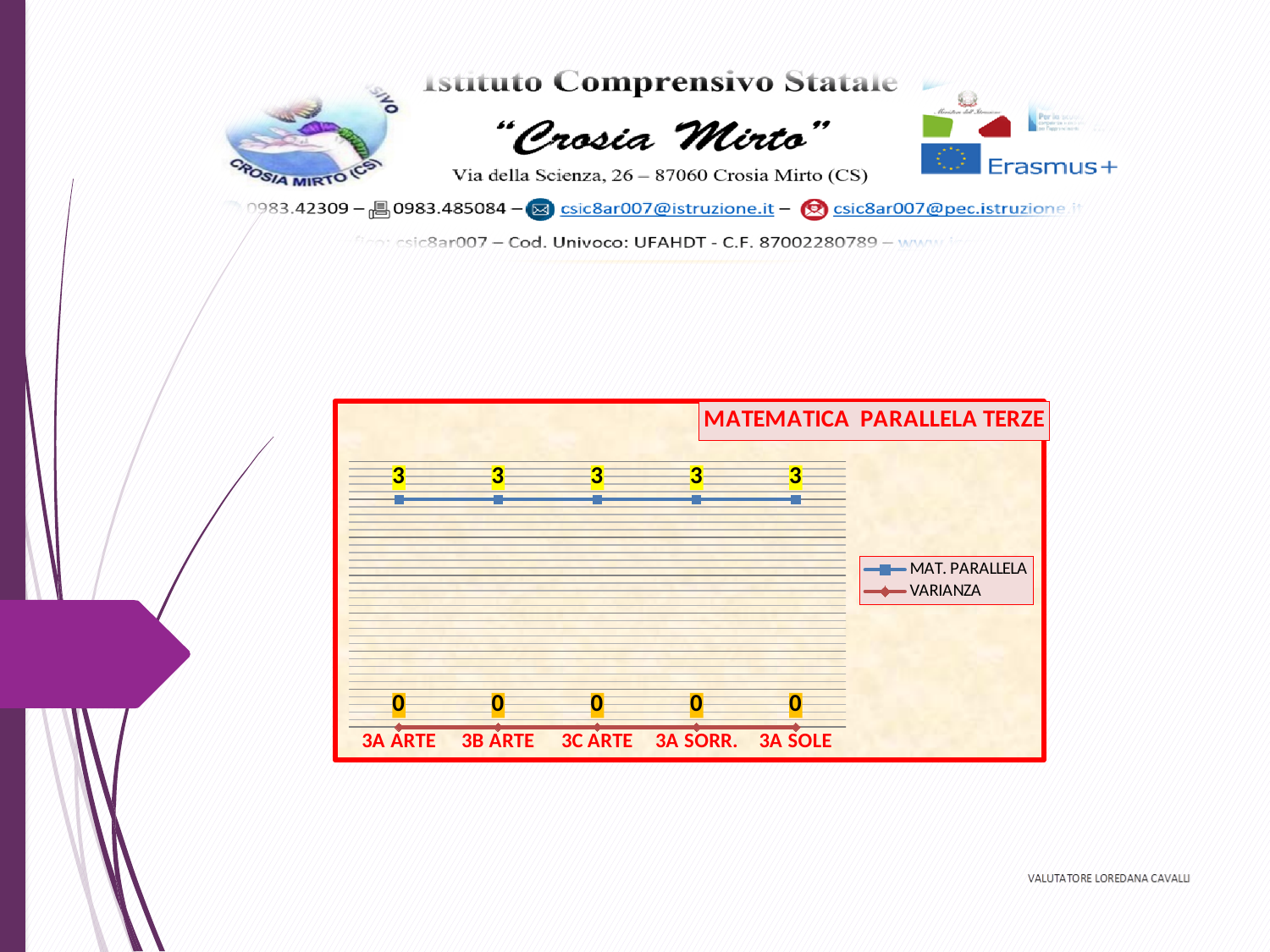
Do the MAT. PARALLELA values rise, fall or stay flat across the x axis? stay flat What is the MAT. PARALLELA value for 3A ARTE? 3 What is the VARIANZA value for 3C ARTE? 0 What is the title of the chart? MATEMATICA PARALLELA TERZE How many categories are shown on the x axis of the chart? 5 Which series is drawn in red in the chart? VARIANZA Which is larger for 3B ARTE, the MAT. PARALLELA value or the VARIANZA value? MAT. PARALLELA What kind of chart is shown on the slide? line chart What is the difference between the MAT. PARALLELA value and the VARIANZA value for 3C ARTE? 3 What is the MAT. PARALLELA value for 3A SOLE? 3 What is the VARIANZA value for 3A SORR.? 0 How many series does the chart legend list? 2